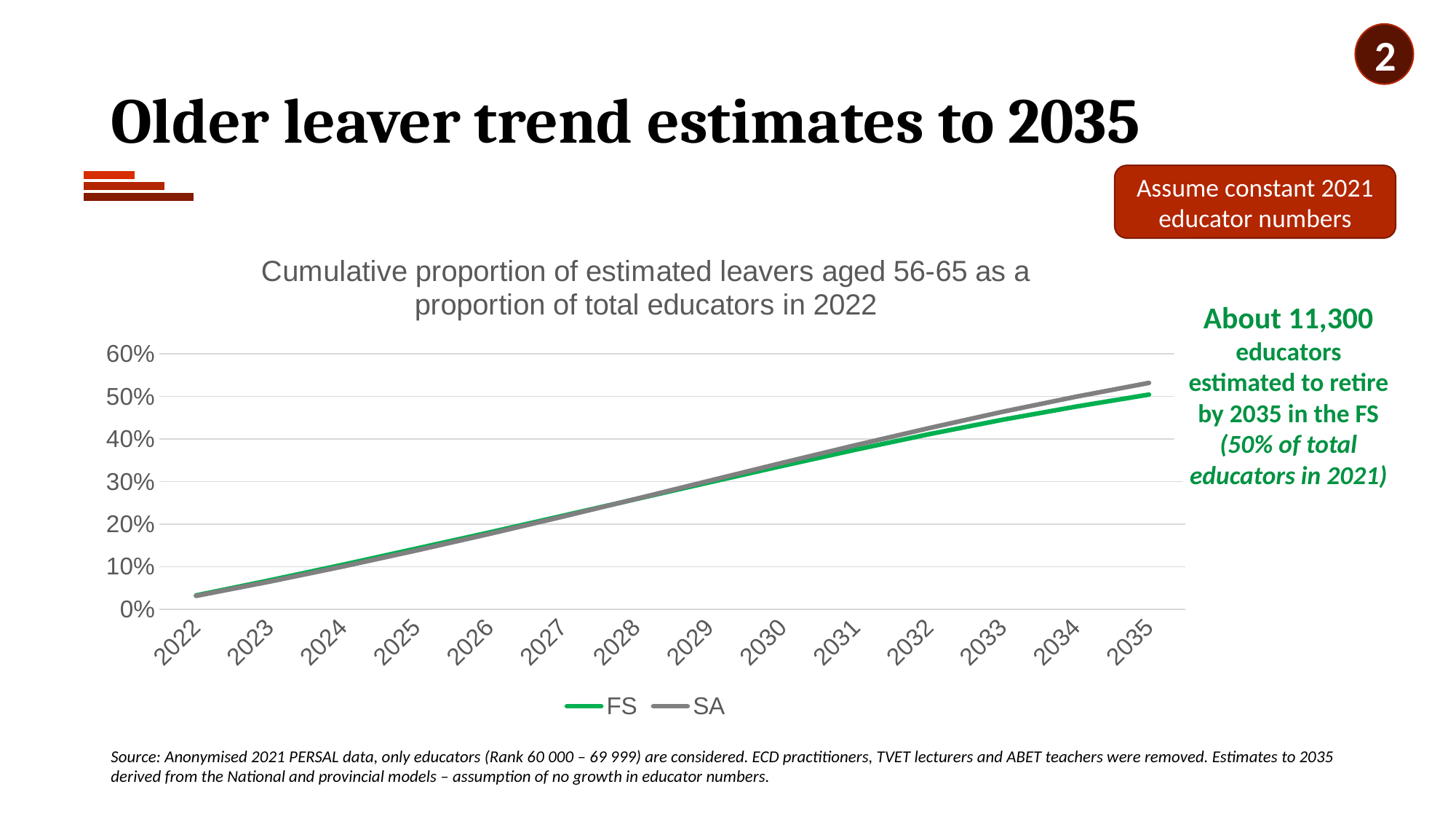
What is the title of the chart? Cumulative proportion of estimated leavers aged 56-65 as a proportion of total educators in 2022 Do the values for SA rise or fall from 2022 to 2035? rise What kind of chart is shown on the slide? line chart How many years are shown along the x axis of the chart? 14 Is the value for FS in 2022 greater or less than 10%? less Is the value for SA in 2028 greater or less than 20%? greater How many series does the chart's legend list? 2 Is the value for SA in 2035 greater or less than 40%? greater Do the values for FS rise or fall from 2022 to 2035? rise Which series is drawn in green in the chart? FS In 2035, which series has the higher value, FS or SA? SA